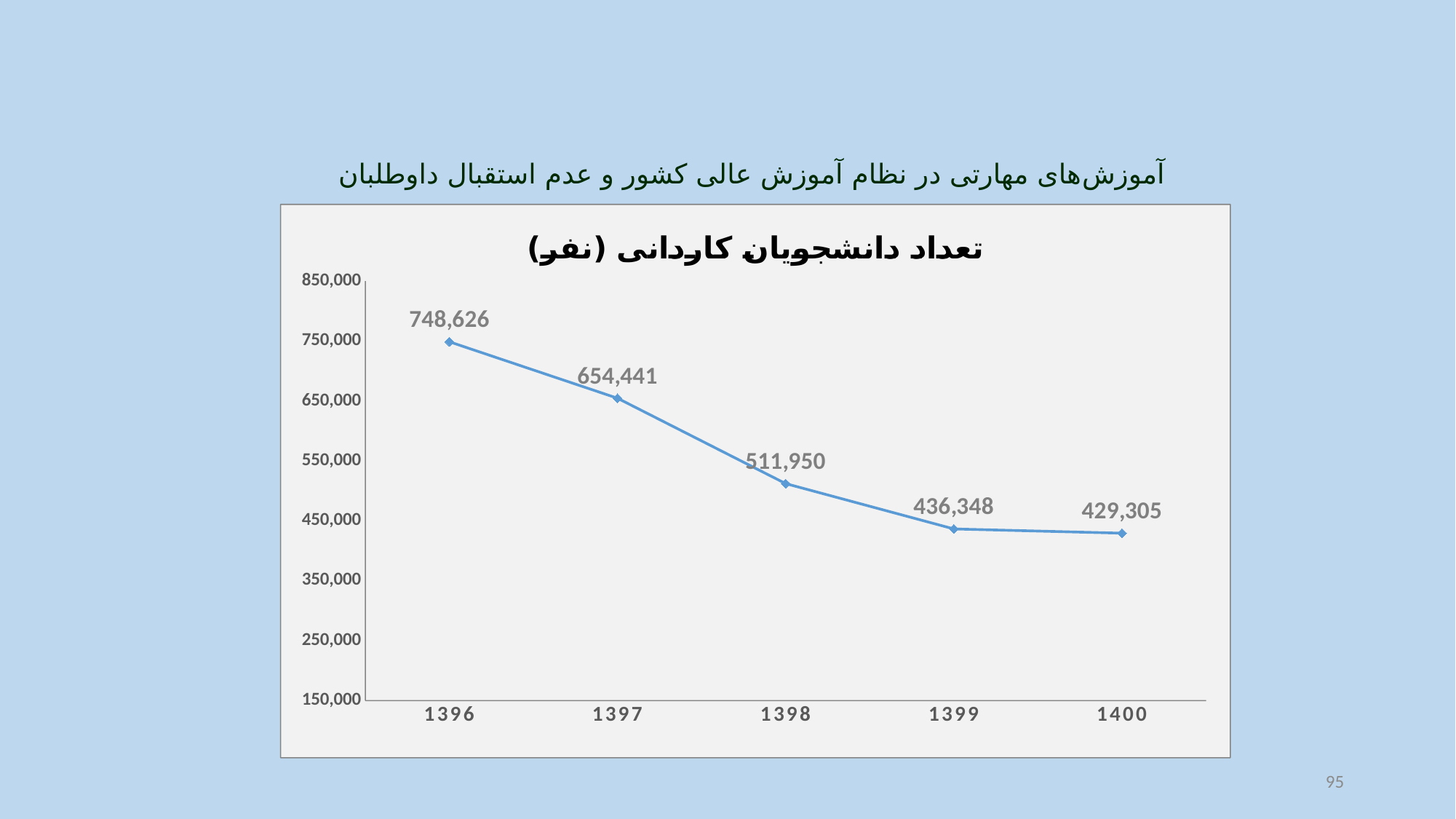
What is the value for 1400? 429,305 What is the difference between the values for 1396 and 1397? 94,185 Which year has the highest value? 1396 Which is larger, the value for 1397 or the value for 1399? 1397 What is the difference between the values for 1397 and 1398? 142,491 What is the value for 1396? 748,626 What is the value for 1398? 511,950 How many data points are plotted on the line? 5 Which year has the lowest value? 1400 What is the difference between the values for 1396 and 1400? 319,321 What type of chart is shown on the slide? line chart Do the values rise or fall from 1396 to 1400? fall